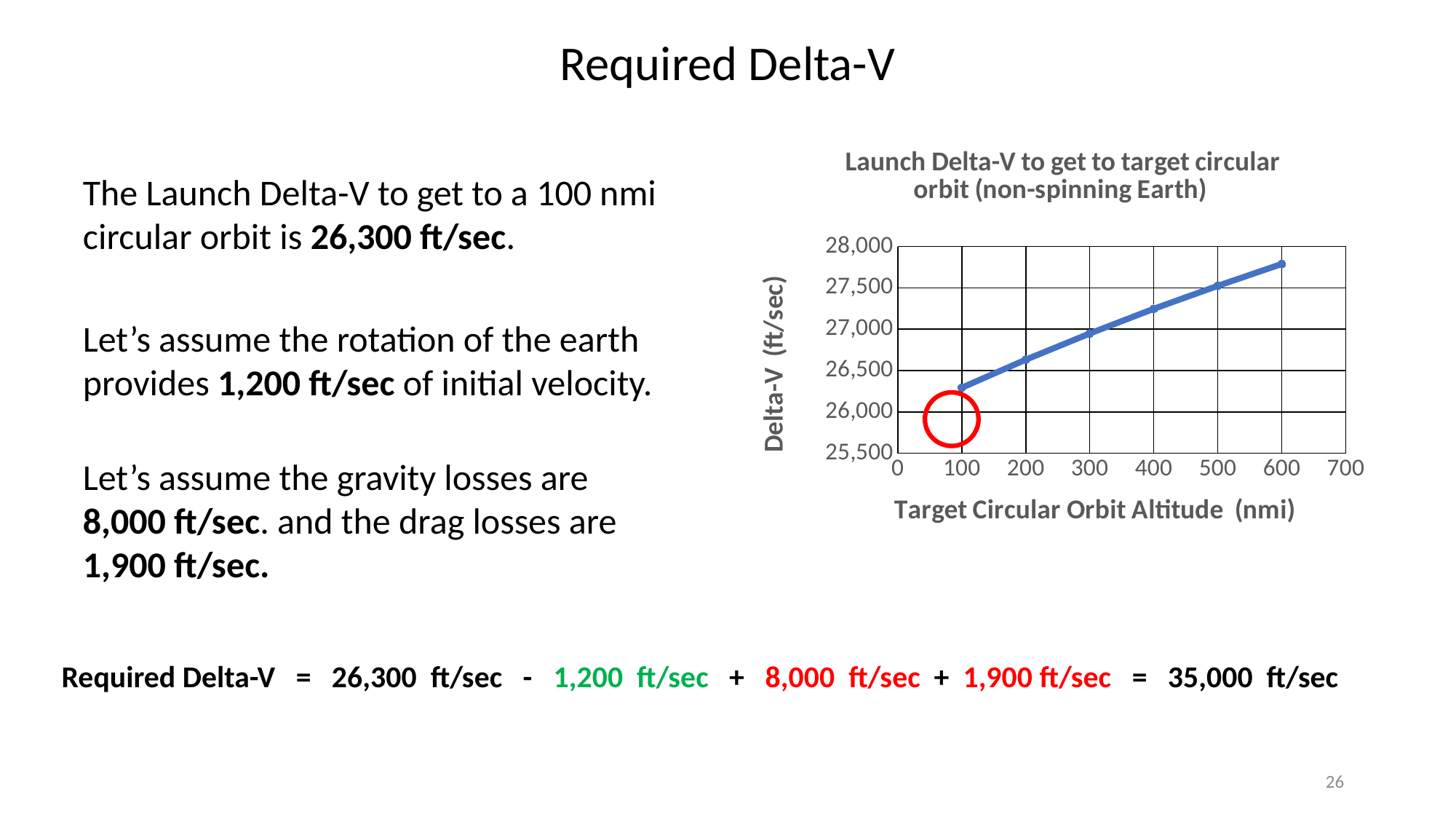
At which target circular orbit altitude is the Delta-V highest? 600 Is the Delta-V at 100 nmi greater or less than 26,500 ft/sec? less Which has the larger Delta-V, 200 nmi or 500 nmi? 500 nmi What is the title of the chart? Launch Delta-V to get to target circular orbit (non-spinning Earth) Does the Delta-V rise or fall as the target circular orbit altitude increases? rises How many data points are plotted on the line? 6 Is the Delta-V at 600 nmi greater or less than 28,000 ft/sec? less Is the Delta-V at 400 nmi greater or less than 27,000 ft/sec? greater At which target circular orbit altitude is the Delta-V lowest? 100 What kind of chart is shown on the slide? line chart What is the label of the x axis of the chart? Target Circular Orbit Altitude (nmi)